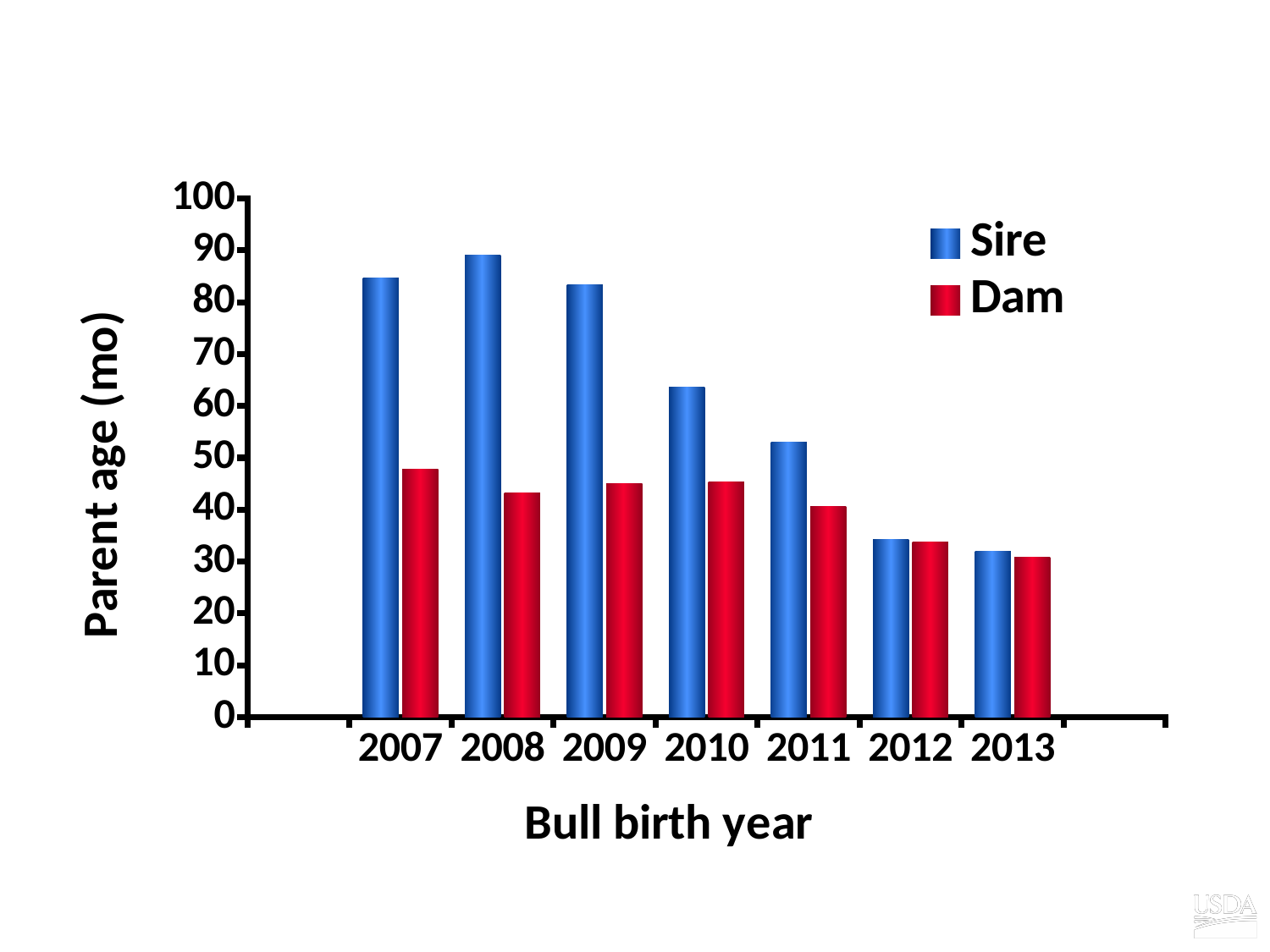
Is the Sire value for 2010 greater or less than 60? greater Is the Dam value for 2007 greater or less than 50? less For bull birth year 2007, which is larger, the Sire or the Dam parent age? Sire Is the Sire value for 2012 greater or less than 40? less Which bull birth year has the highest Sire parent age? 2008 How many series does the legend list? 2 Which bull birth year has the lowest Dam parent age? 2013 What is the label of the y axis? Parent age (mo) How many bull birth years are shown on the x axis? 7 What kind of chart is shown on the slide? bar chart Do the Sire values rise or fall from 2007 to 2013? fall